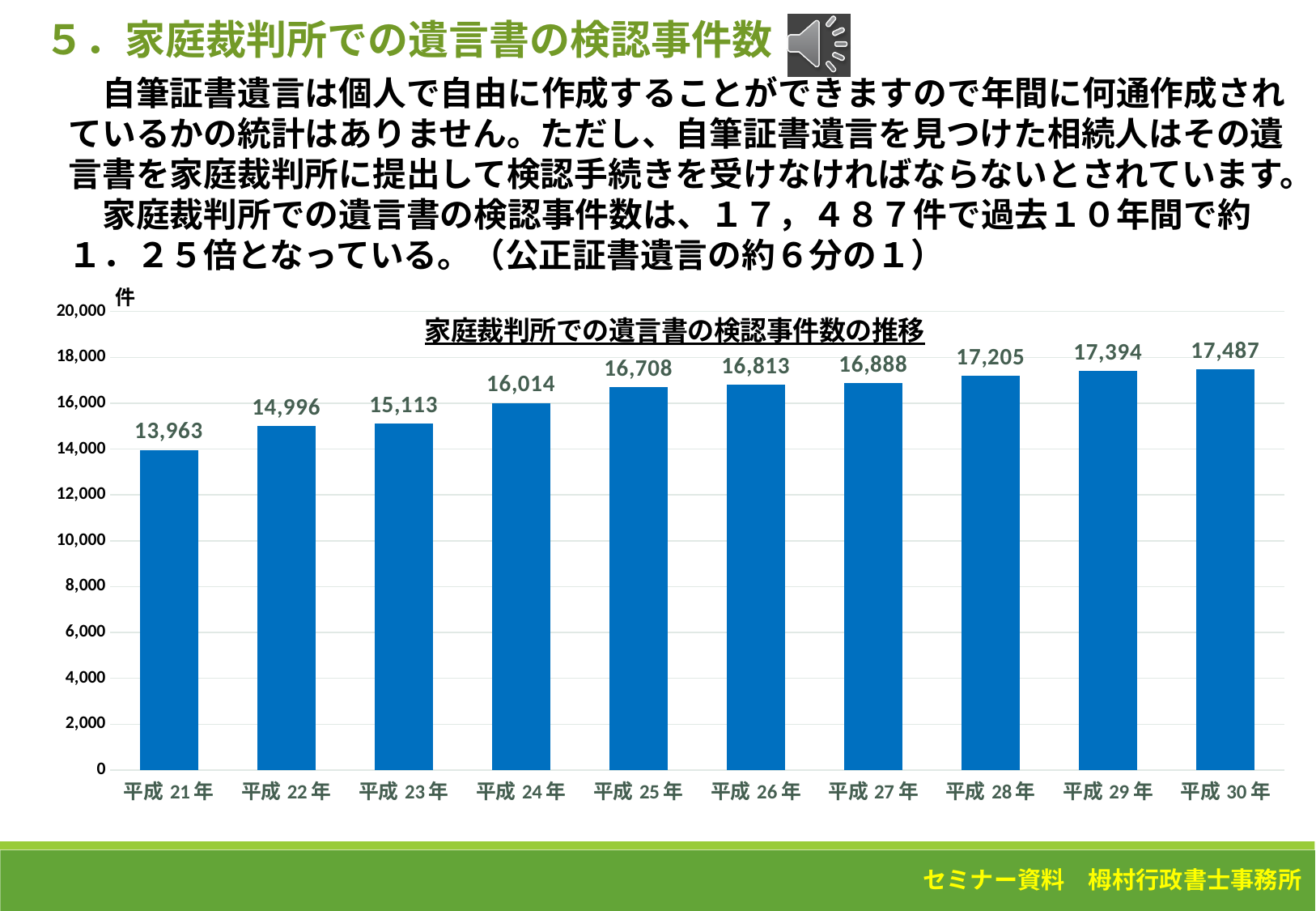
How many years are shown on the x axis? 10 Is the value for 平成 27 年 greater or less than 16,000? greater Which year has the highest value? 平成 30 年 Do the values rise or fall from 平成 21 年 to 平成 30 年? rise Which year has the lowest value? 平成 21 年 What is the difference between the values for 平成 30 年 and 平成 21 年? 3,524 What is the value for 平成 25 年? 16,708 What kind of chart is shown? bar chart What is the value for 平成 30 年? 17,487 What is the value for 平成 21 年? 13,963 Which is larger, the value for 平成 22 年 or the value for 平成 28 年? 平成 28 年 What is the difference between the values for 平成 24 年 and 平成 23 年? 901